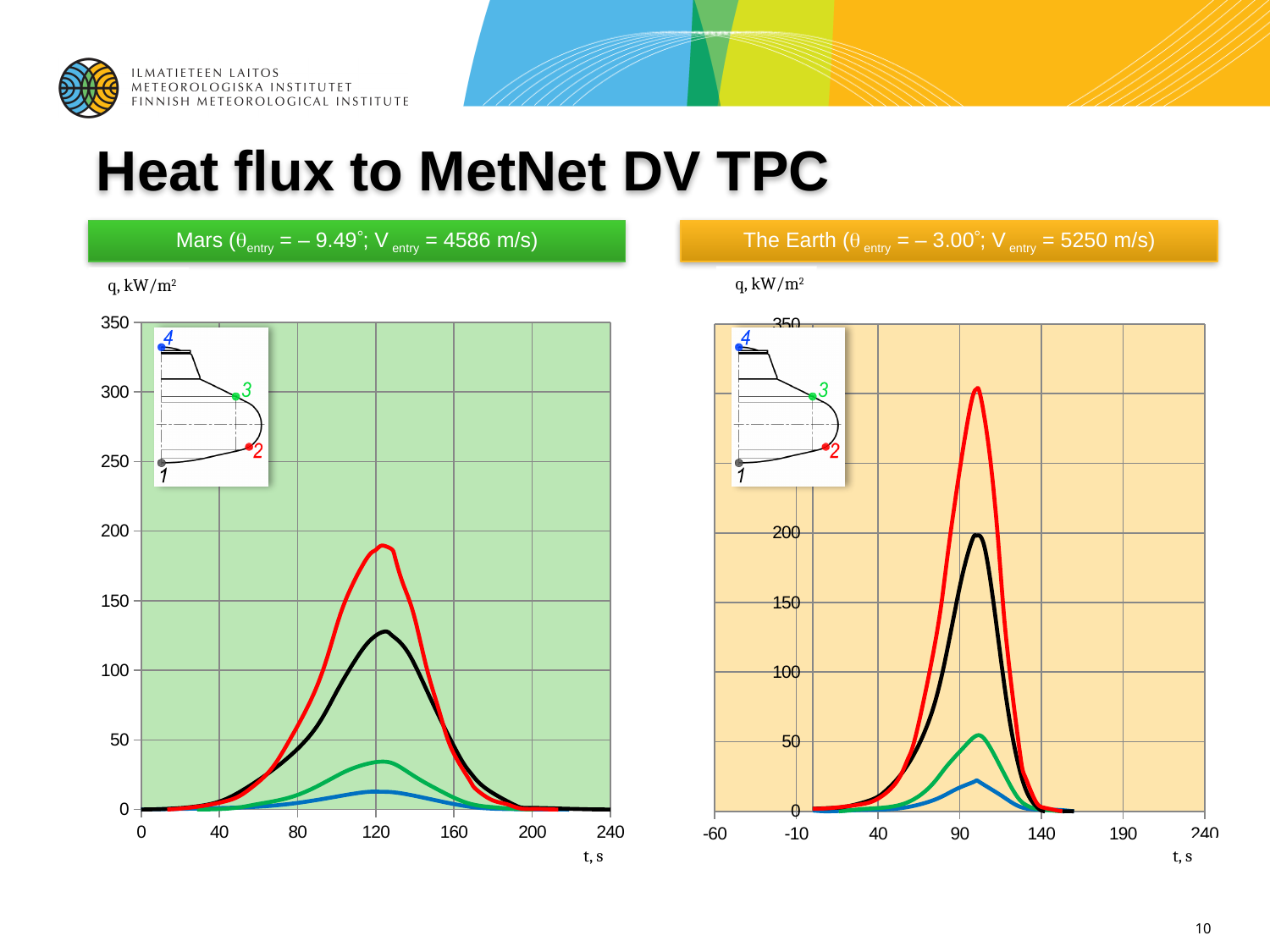
What kind of chart is the Mars chart on the left? line chart How many curves are plotted on the Earth chart on the right? 4 On the Mars chart, is the peak value of the green curve greater or less than 50? less Is the peak of the red curve higher on the Earth chart or on the Mars chart? the Earth chart On the Earth chart, which coloured curve has the lowest peak? blue What is the y-axis label on the Mars chart? q, kW/m² On the Mars chart, is the peak value of the red curve greater or less than 200? less On the Mars chart, which coloured curve reaches the highest peak? red According to the Earth chart's title, what is the entry velocity V entry? 5250 m/s On the Earth chart, is the peak value of the red curve greater or less than 250? greater